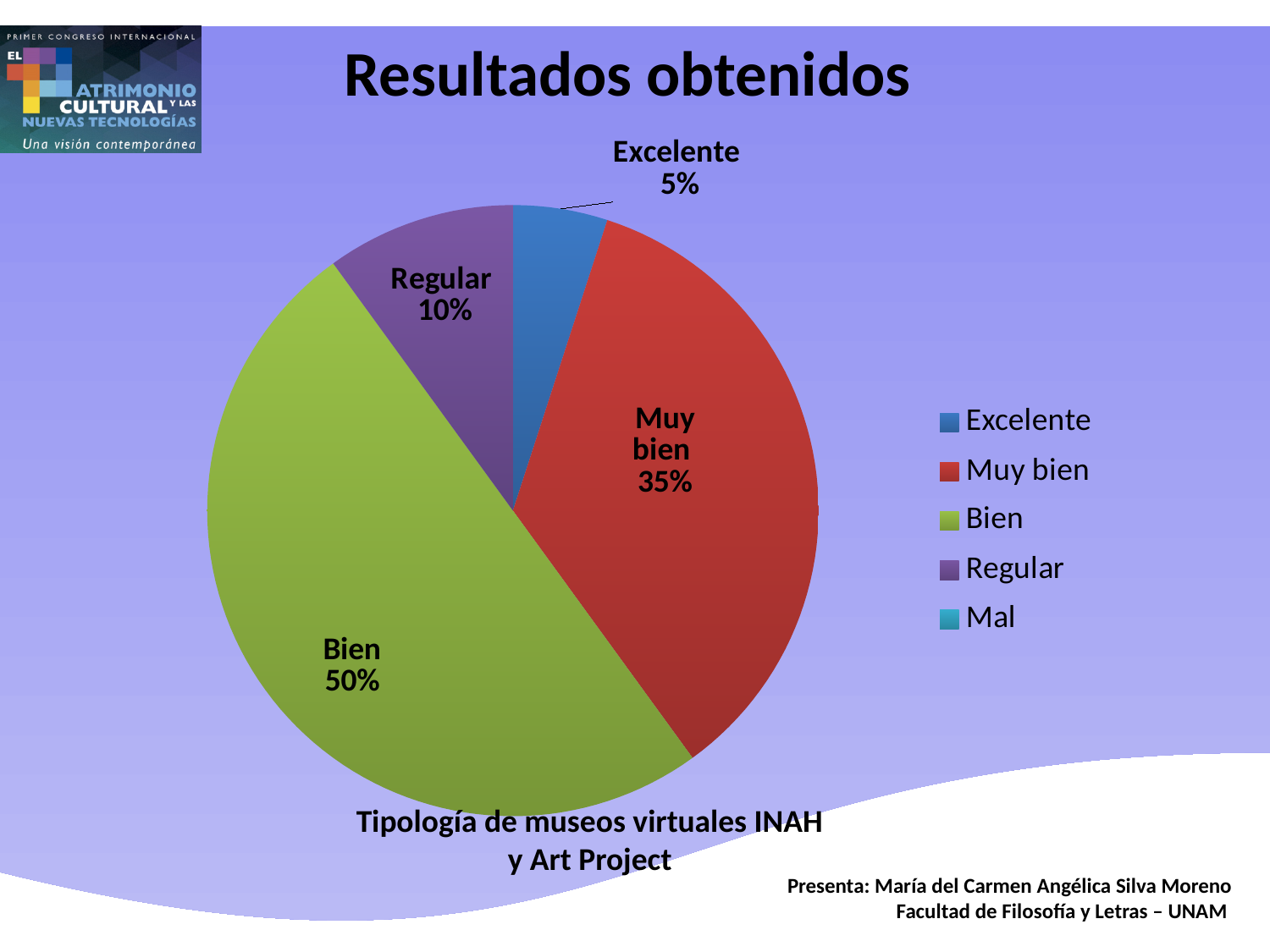
How many entries does the chart legend list? 5 What type of chart is shown on the slide? Pie chart What percentage is shown for "Excelente"? 5% By how many percentage points does "Bien" exceed "Muy bien"? 15 percentage points What is the title printed below the pie chart? Tipología de museos virtuales INAH y Art Project What percentage is shown for "Muy bien"? 35% Which slice is larger, "Regular" or "Excelente"? Regular What is the combined share of "Bien" and "Muy bien"? 85% What percentage of the pie does the "Bien" slice represent? 50% Which category has the largest slice of the pie? Bien Among the slices with a printed percentage, which is the smallest? Excelente What percentage is shown for "Regular"? 10%